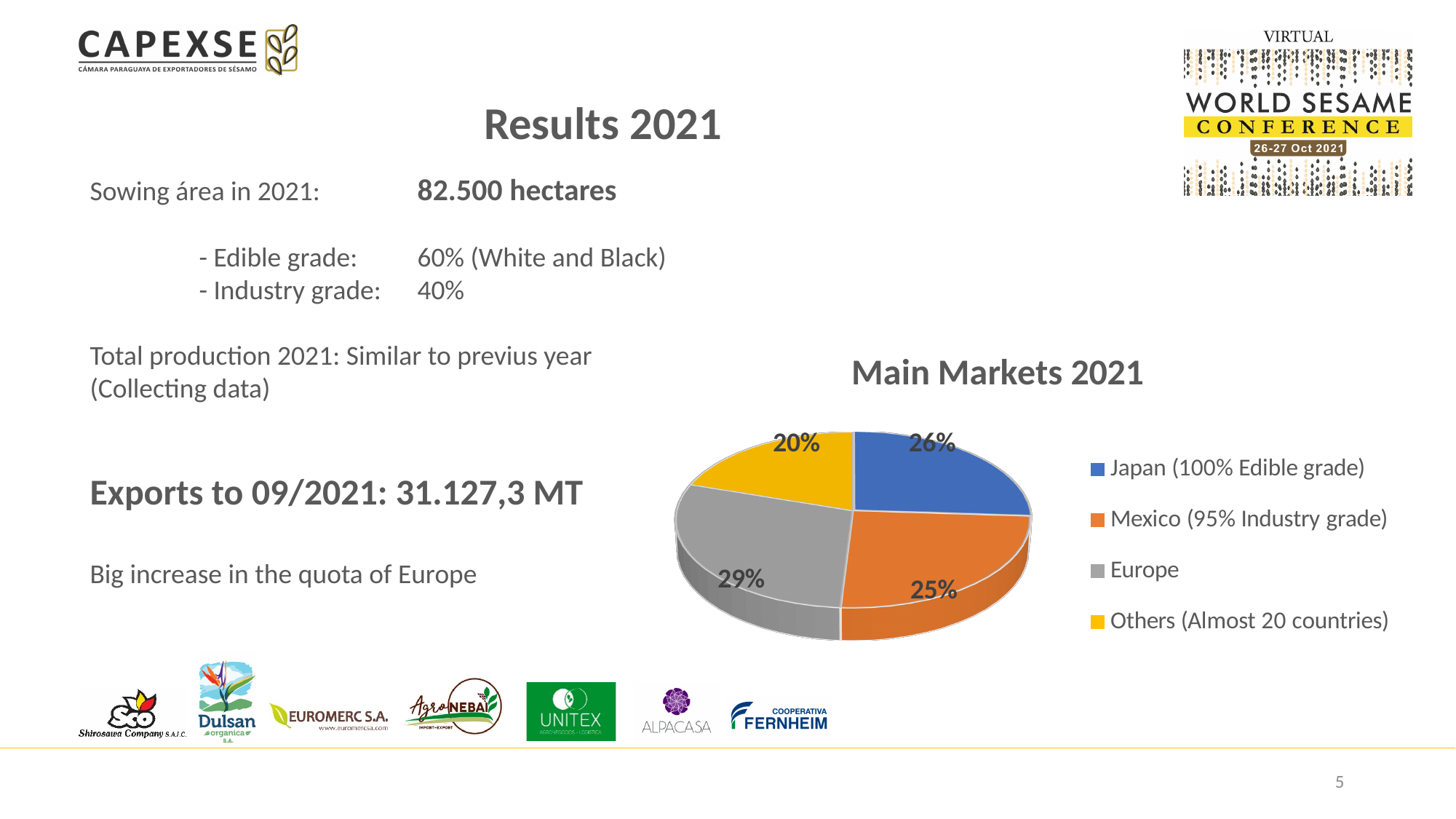
What share of the pie does Europe hold? 29% What is the difference in percentage points between Europe's share and Others' share? 9 What share of the pie does Japan (100% Edible grade) hold? 26% What colour is the slice for Mexico (95% Industry grade)? orange How many slices does the pie chart have? 4 What is the title of the chart? Main Markets 2021 Which market has the largest share of the pie? Europe What kind of chart is shown on the slide? pie chart What share of the pie does Others (Almost 20 countries) hold? 20% Which market has the smallest share of the pie? Others (Almost 20 countries) Which is larger, the share for Japan or the share for Others? Japan